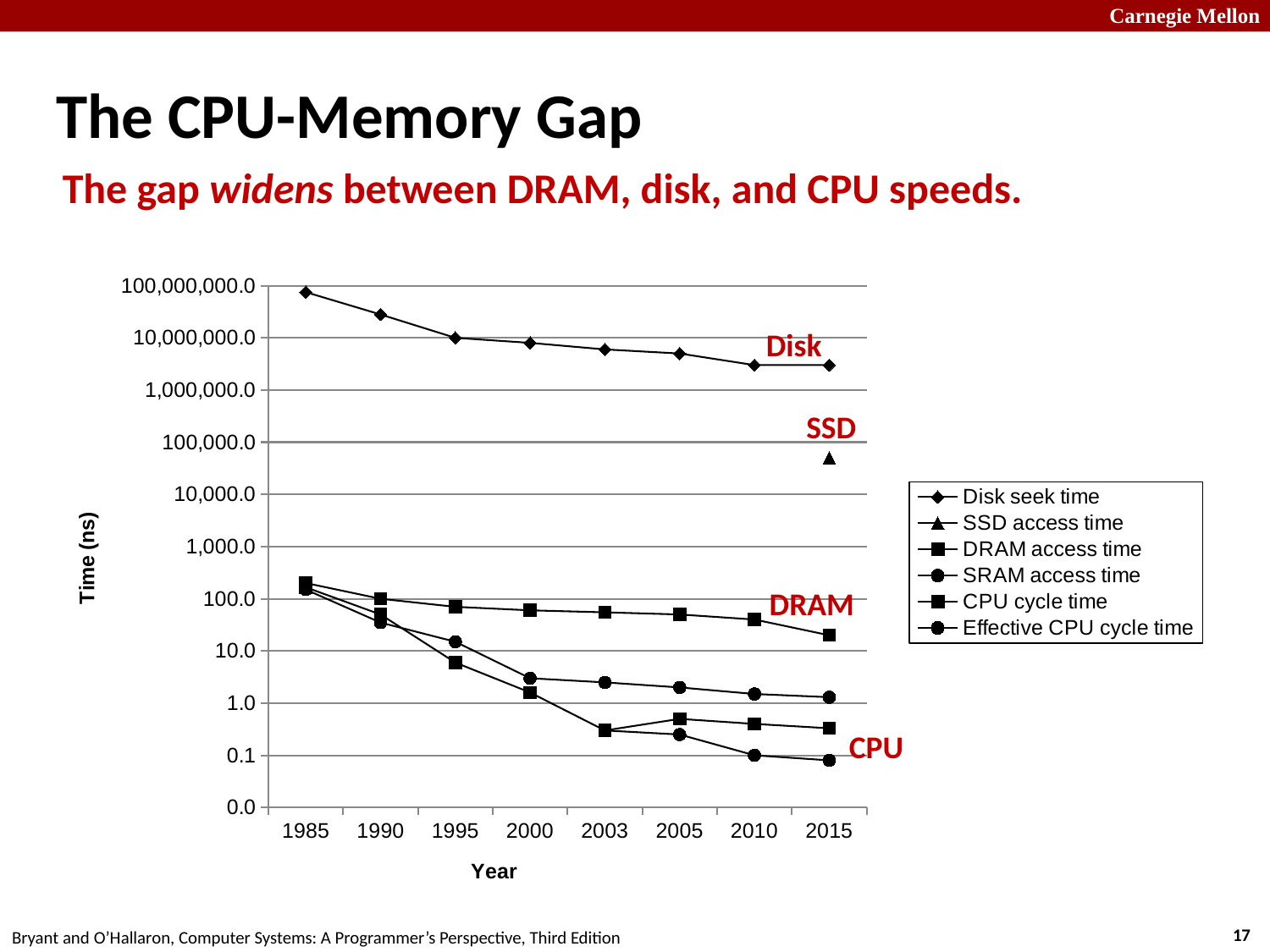
Which series has the lowest value in 2015? Effective CPU cycle time Is the disk seek time in 2015 greater or less than 10,000,000? less How many years are marked along the x axis? 8 Does the disk seek time rise or fall from 1985 to 2015? fall In 2015, which is larger: the disk seek time or the DRAM access time? Disk seek time What kind of chart is shown on the slide? line chart How many series does the legend list? 6 What is the label of the y axis? Time (ns) Is the disk seek time in 1985 greater or less than 10,000,000? greater Which series has the highest value in 2015? Disk seek time Is the DRAM access time in 2015 greater or less than 100? less